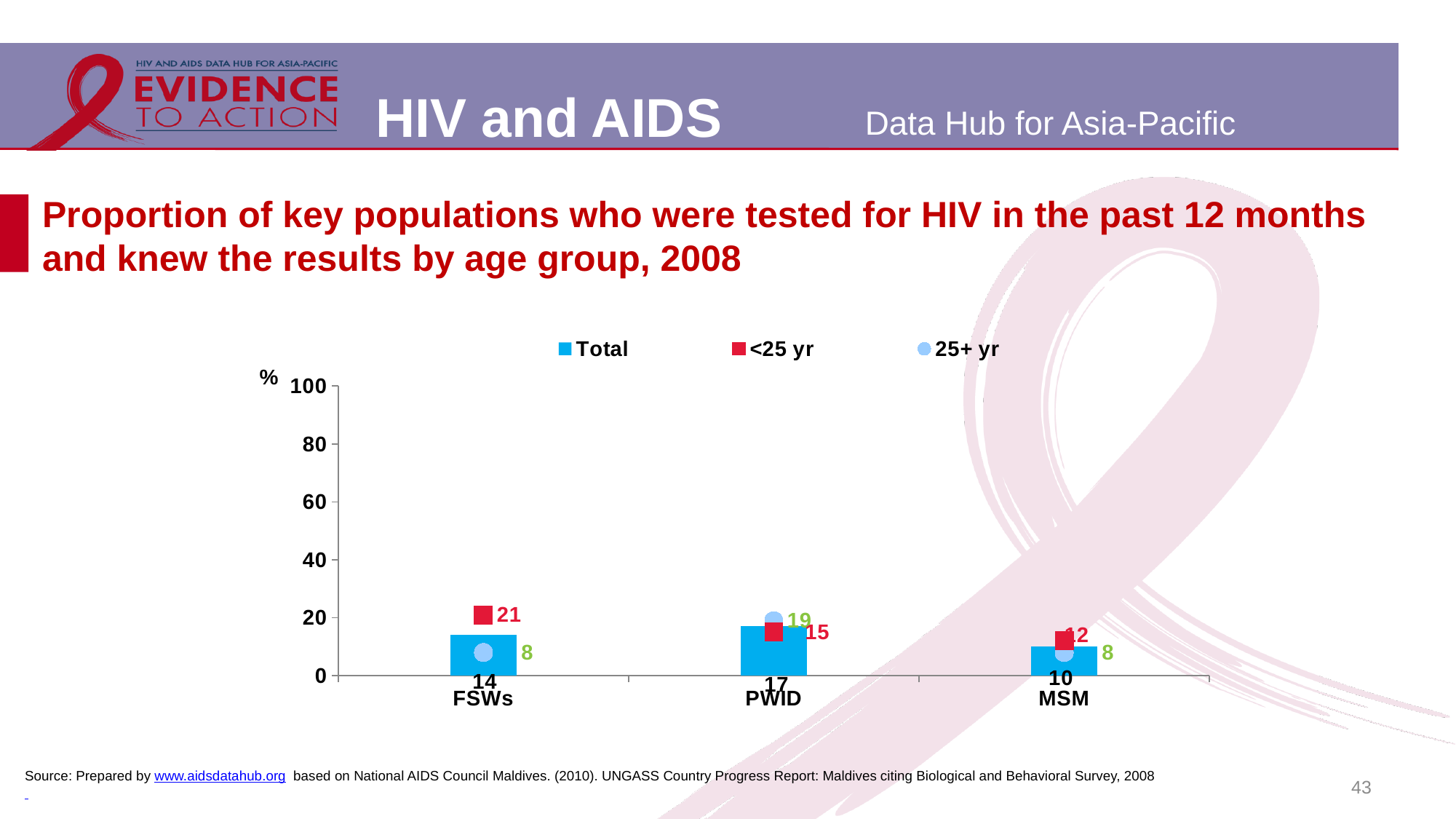
Is the Total value for FSWs greater or less than 20? less How many key populations are shown on the x axis? 3 How many series does the legend list? 3 For PWID, which is larger: the <25 yr value or the 25+ yr value? 25+ yr What is the Total value for PWID? 17 What is the Total value for MSM? 10 What unit is shown on the y axis? % Which key population has the highest Total value? PWID What is the 25+ yr value for PWID? 19 What is the difference between the <25 yr and 25+ yr values for FSWs? 13 What is the <25 yr value for FSWs? 21 Which key population has the lowest Total value? MSM